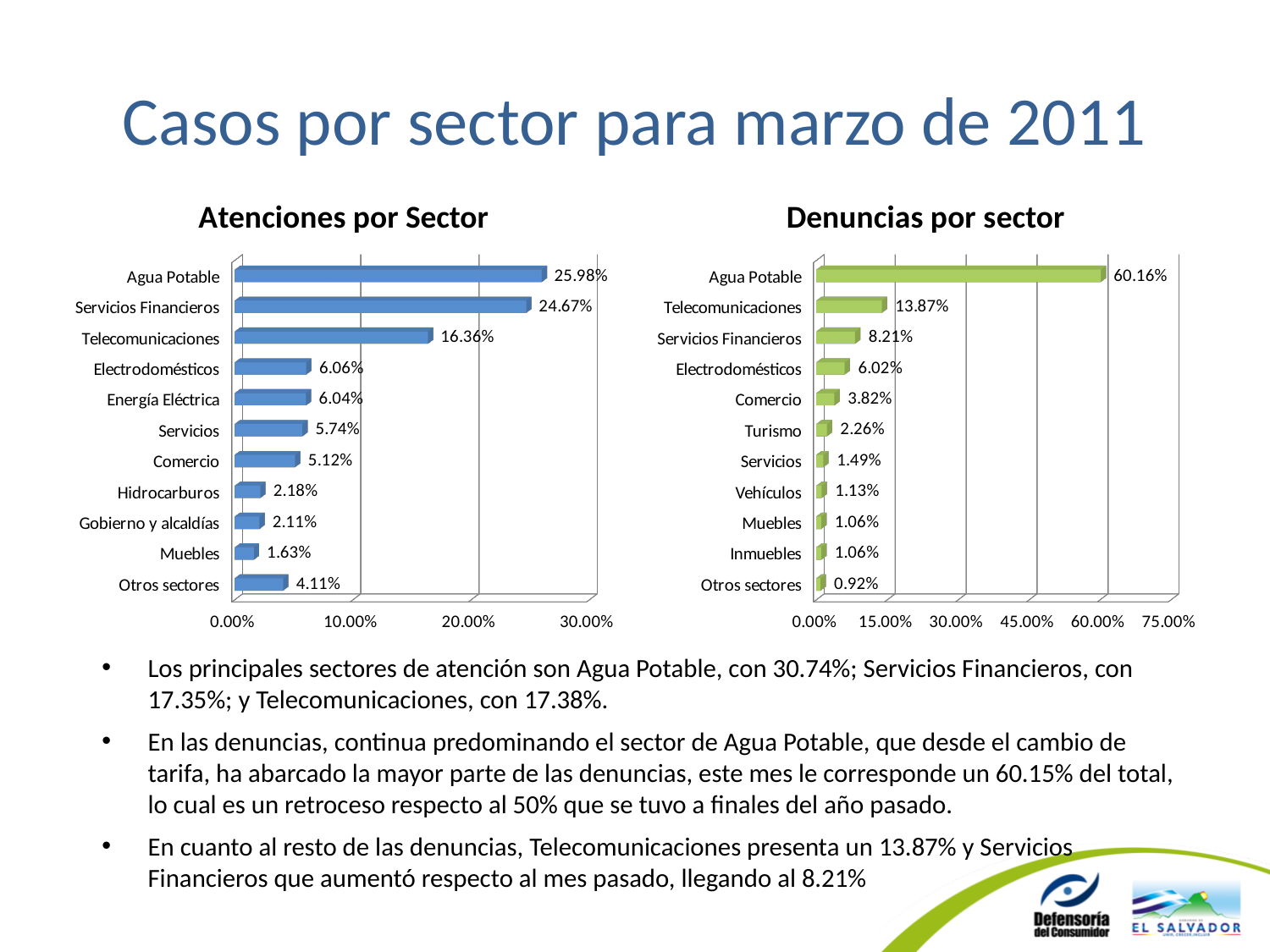
In the 'Denuncias por sector' chart, what is the difference between Agua Potable and Telecomunicaciones? 46.29% In the 'Atenciones por Sector' chart, which category has the lowest value? Muebles What is the title of the chart on the left side of the slide? Atenciones por Sector In the 'Denuncias por sector' chart, what is the value for Servicios Financieros? 8.21% In the 'Atenciones por Sector' chart, which is larger: Hidrocarburos or Otros sectores? Otros sectores In the 'Atenciones por Sector' chart, what is the difference between Agua Potable and Servicios Financieros? 1.31% In the 'Denuncias por sector' chart, which category has the lowest value? Otros sectores How many categories are shown in the 'Atenciones por Sector' chart? 11 In the 'Atenciones por Sector' chart, what is the value for Telecomunicaciones? 16.36% In the 'Atenciones por Sector' chart, which category has the highest value? Agua Potable In the 'Denuncias por sector' chart, is the value for Agua Potable greater or less than 45.00%? greater What kind of chart is 'Denuncias por sector'? Bar chart